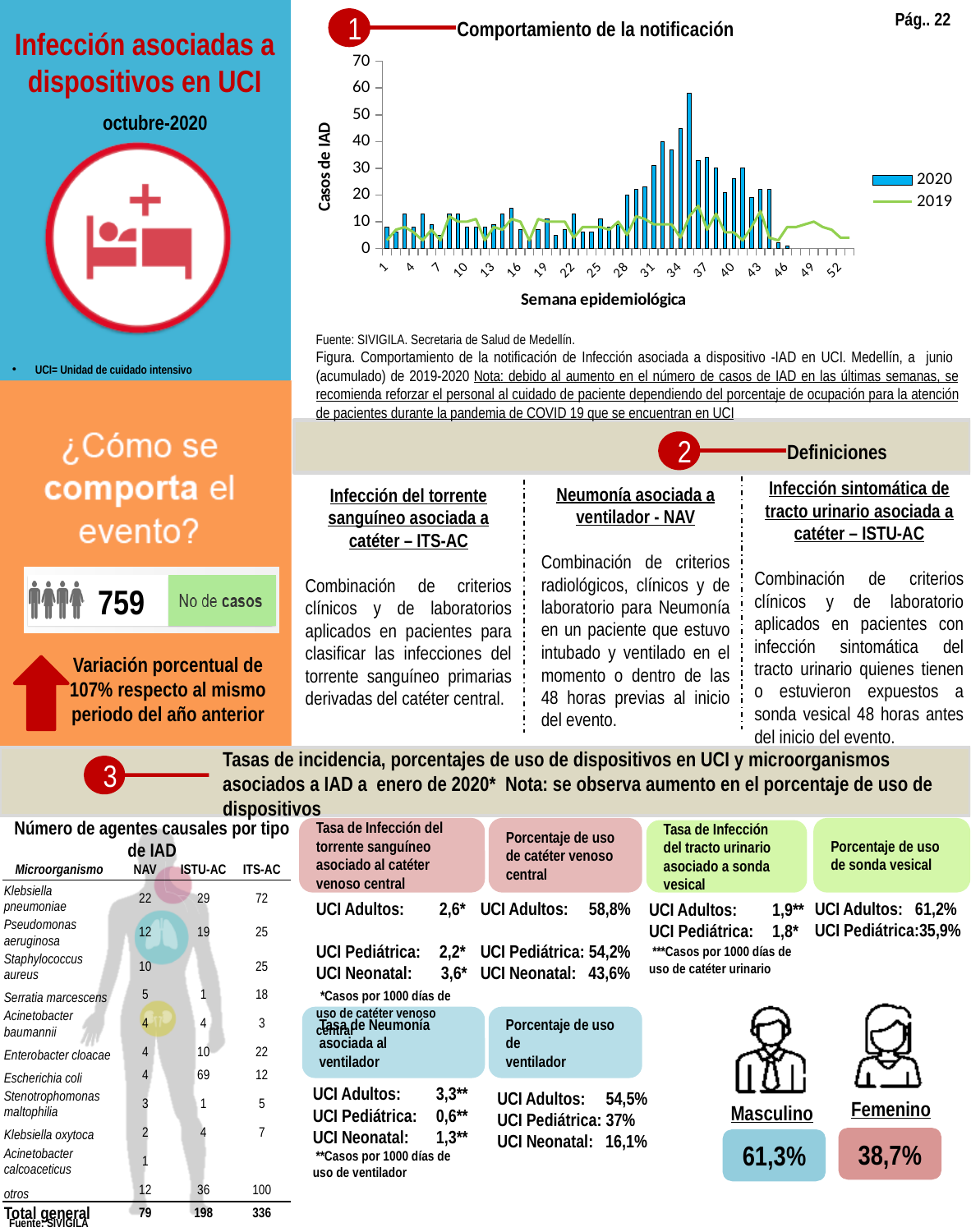
In the 'Comportamiento de la notificación' chart, is the 2019 value at week 36 greater or less than 20? less In the 'Comportamiento de la notificación' chart, is the 2020 value at week 35 greater or less than 50? greater What is the highest tick value shown on the vertical axis of the 'Comportamiento de la notificación' chart? 70 In the 'Comportamiento de la notificación' chart, is the 2020 value at week 1 greater or less than 10? less In the 'Comportamiento de la notificación' chart, do the 2020 values rise or fall from week 27 to week 35? rise Which years are listed in the legend of the 'Comportamiento de la notificación' chart? 2020 and 2019 In the 'Comportamiento de la notificación' chart, do the 2020 values rise or fall from week 35 to week 46? fall In the 'Comportamiento de la notificación' chart, which series has the larger value at week 35, 2020 or 2019? 2020 What is the title of the vertical axis of the 'Comportamiento de la notificación' chart? Casos de IAD How many series does the legend of the 'Comportamiento de la notificación' chart list? 2 What kind of chart is 'Comportamiento de la notificación'? bar chart with a line